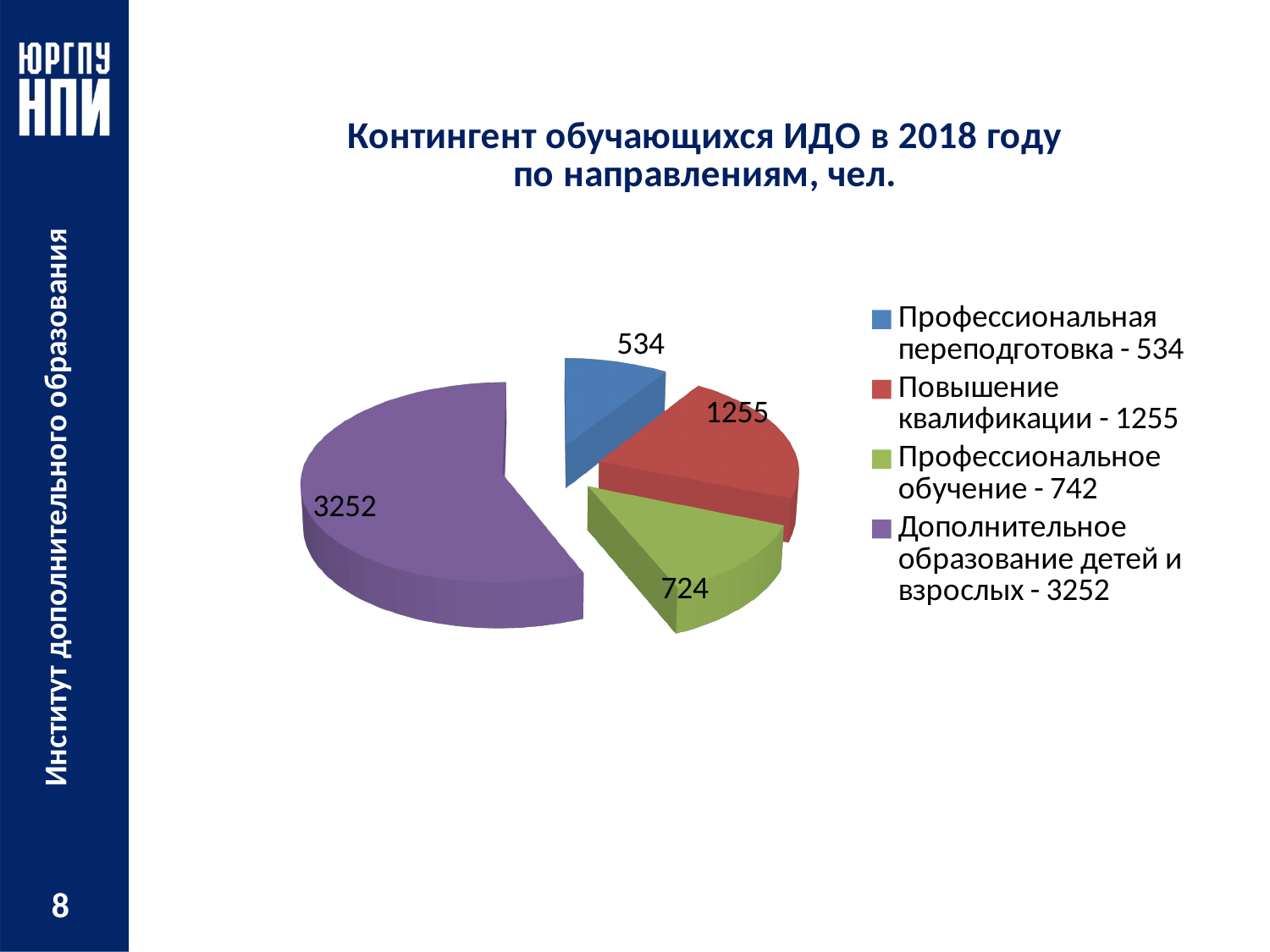
What is the difference between the values for Дополнительное образование детей и взрослых and Повышение квалификации? 1997 What is the value for Профессиональная переподготовка? 534 Which category has the largest slice of the pie? Дополнительное образование детей и взрослых Which is larger: Повышение квалификации or Профессиональная переподготовка? Повышение квалификации What is the value for Дополнительное образование детей и взрослых? 3252 What is the difference between the values for Повышение квалификации and Профессиональная переподготовка? 721 What is the value for Повышение квалификации? 1255 What is the title of the chart? Контингент обучающихся ИДО в 2018 году по направлениям, чел. How many slices does the pie chart have? 4 Which category has the smallest slice of the pie? Профессиональная переподготовка What kind of chart is shown on the slide? Pie chart What colour is the slice for Дополнительное образование детей и взрослых? Purple